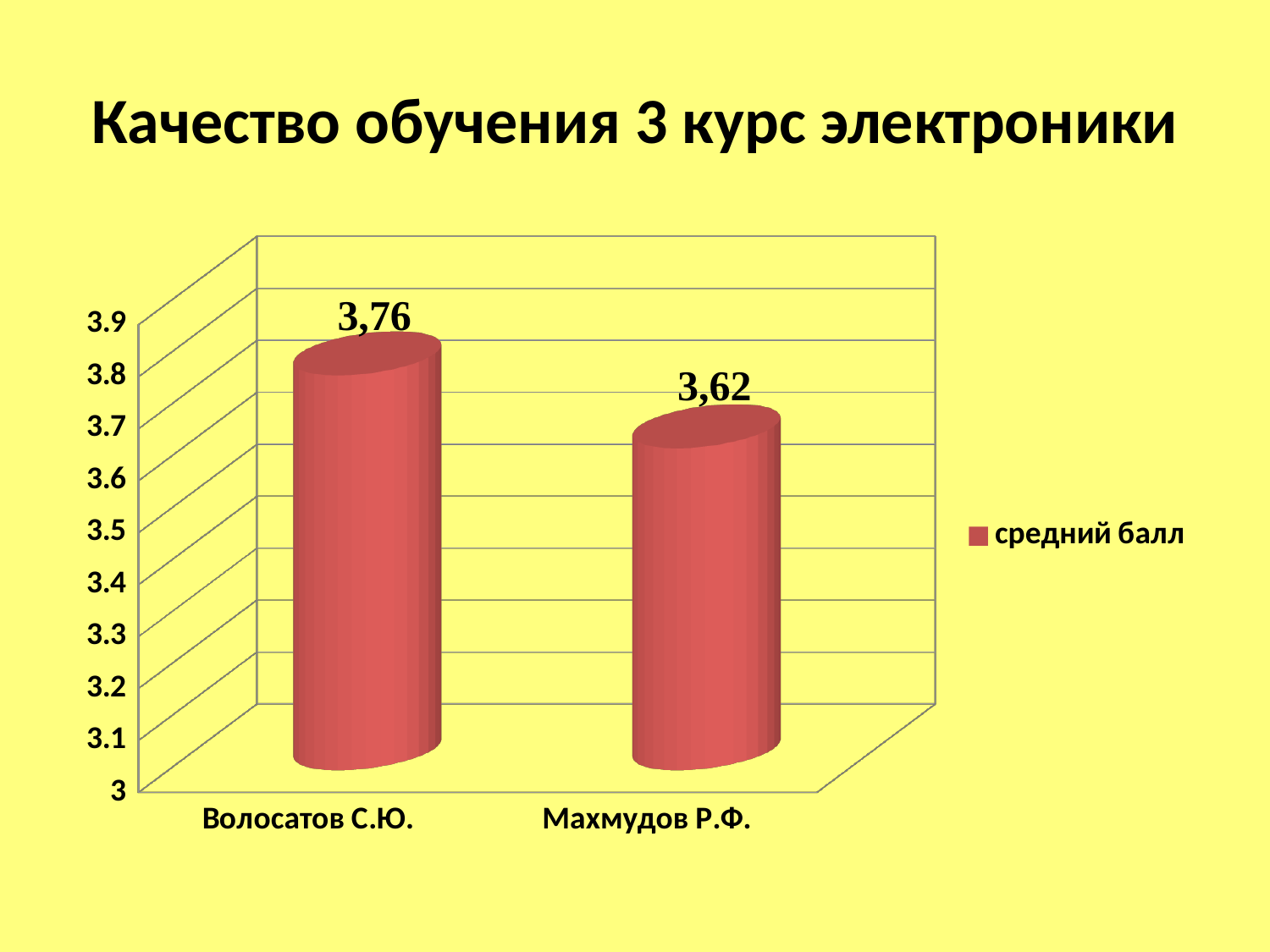
Which category has the highest value? Волосатов С.Ю. Is the value for Махмудов Р.Ф. greater or less than 3.7? less How many categories are shown on the chart? 2 What is the value for Волосатов С.Ю.? 3,76 How many series does the legend list? 1 What kind of chart is shown on the slide? bar chart What is the difference between the values for Волосатов С.Ю. and Махмудов Р.Ф.? 0,14 What is the value for Махмудов Р.Ф.? 3,62 What is the title of the slide? Качество обучения 3 курс электроники Which is larger, the value for Волосатов С.Ю. or the value for Махмудов Р.Ф.? Волосатов С.Ю. Is the value for Волосатов С.Ю. greater or less than 3.7? greater Which category has the lowest value? Махмудов Р.Ф.